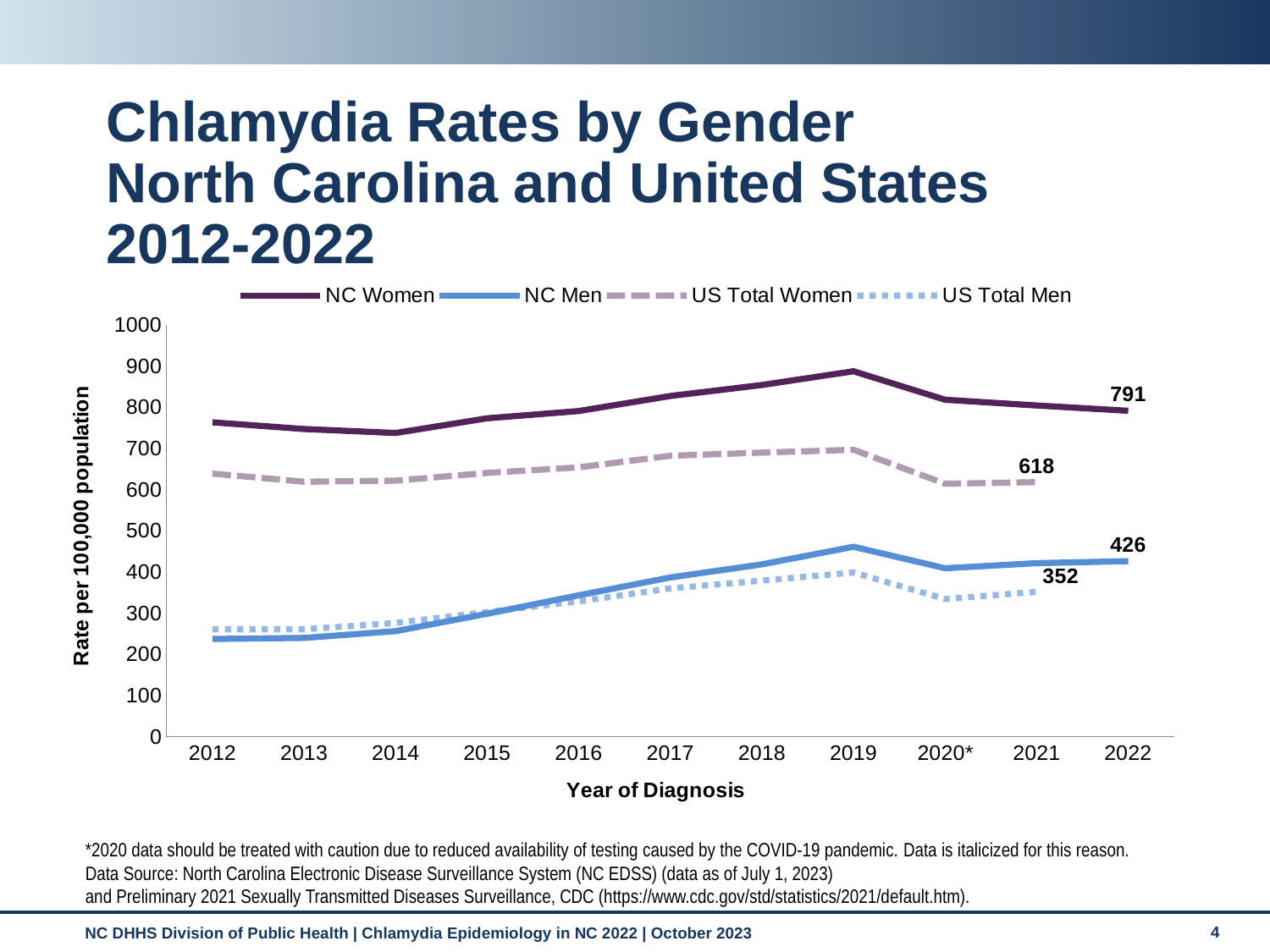
What is the NC Women chlamydia rate in 2022? 791 What is the difference between the US Total Women and US Total Men rates in 2021? 266 What is the US Total Women rate in 2021? 618 What is the NC Men rate in 2022? 426 How many series does the legend list? 4 Is the NC Men rate in 2012 greater or less than 300? less What is the US Total Men rate in 2021? 352 What is the difference between the NC Women and NC Men rates in 2022? 365 Is the NC Women rate in 2019 greater or less than 800? greater How many years are shown on the x axis? 11 In which year does the NC Women line reach its highest point? 2019 What kind of chart is shown on the slide? line chart